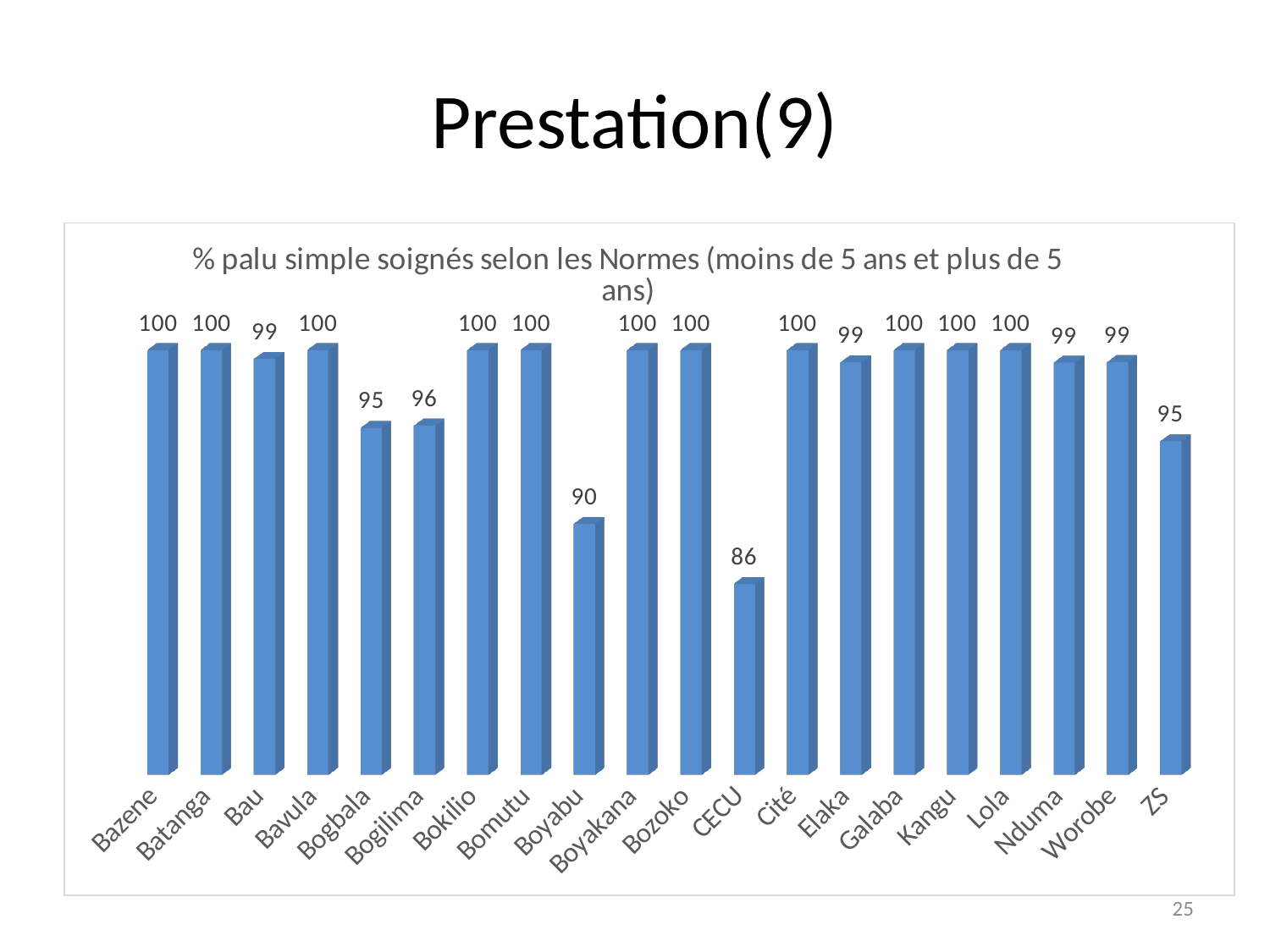
What is the title of the chart? % palu simple soignés selon les Normes (moins de 5 ans et plus de 5 ans) What is the value for Nduma? 99 What is the value for Bogilima? 96 Which category has the lowest value? CECU How many categories are shown on the x axis? 20 Which is larger, the value for Bogbala or the value for Boyabu? Bogbala What is the difference between the values for Bazene and CECU? 14 What is the value for Boyabu? 90 What is the value for ZS? 95 What is the value for CECU? 86 What kind of chart is shown on the slide? Bar chart What is the difference between the values for Bogilima and Boyabu? 6